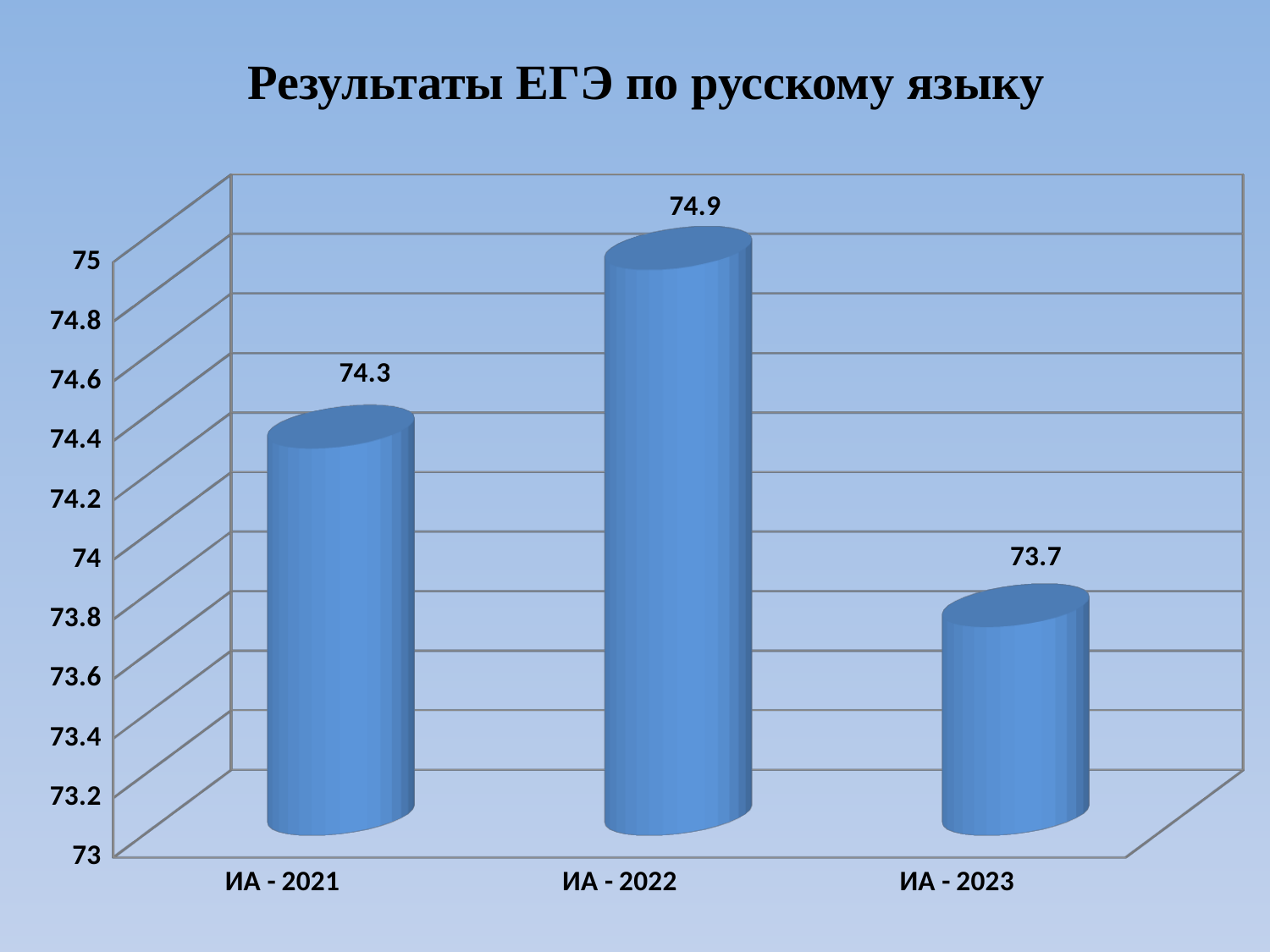
Which category has the highest value? ИА - 2022 What is the title of the chart? Результаты ЕГЭ по русскому языку What is the value for ИА - 2021? 74.3 What is the value for ИА - 2022? 74.9 Is the value for ИА - 2023 greater or less than 74? less What kind of chart is shown on the slide? bar chart Which category has the lowest value? ИА - 2023 What is the difference between the values for ИА - 2021 and ИА - 2023? 0.6 What is the difference between the values for ИА - 2022 and ИА - 2021? 0.6 How many categories are shown on the chart? 3 Which is larger, the value for ИА - 2021 or the value for ИА - 2023? ИА - 2021 What is the value for ИА - 2023? 73.7